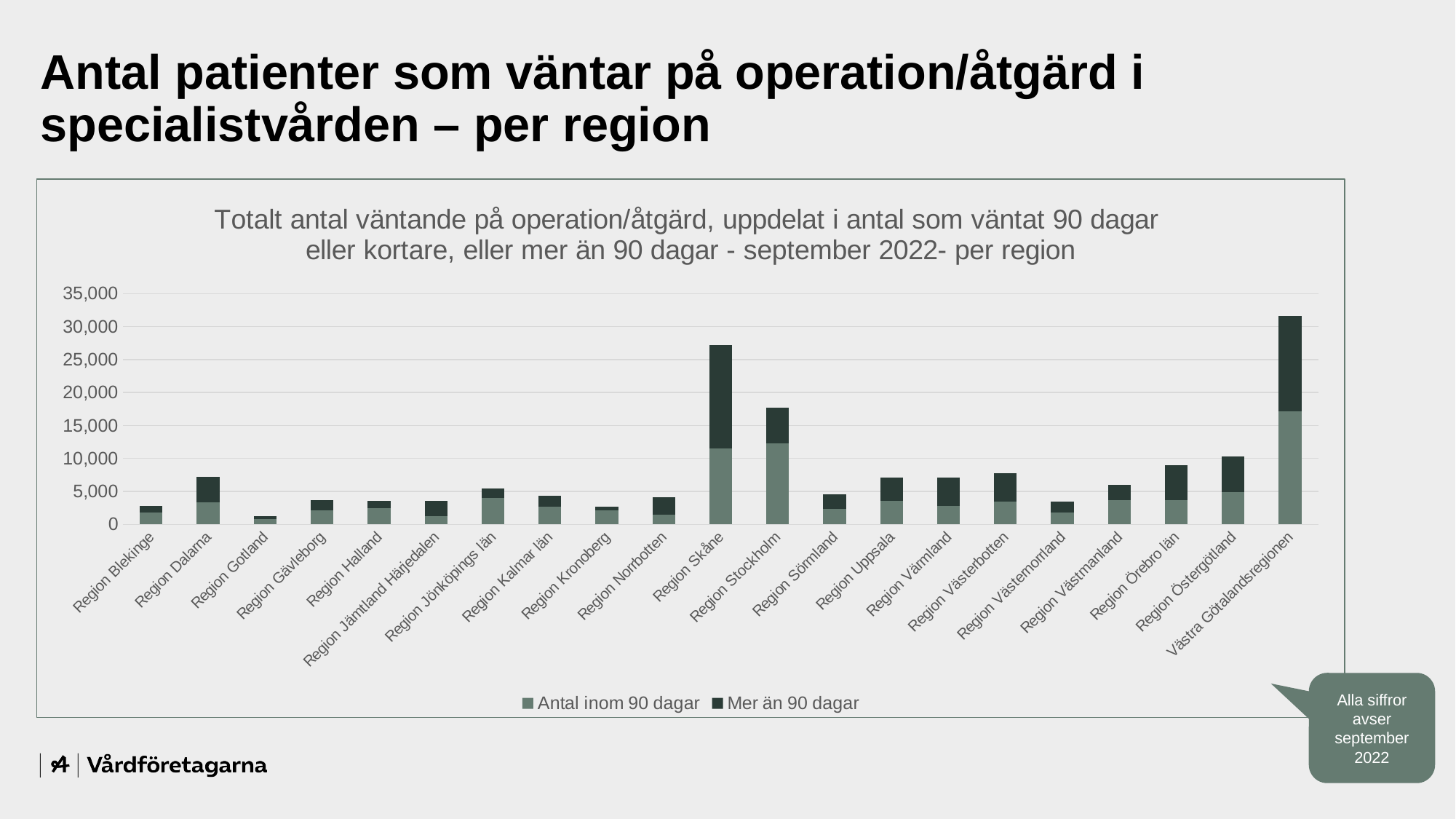
What kind of chart is shown on the slide? Stacked bar chart How many series does the legend list? 2 Which region has the highest total number of waiting patients? Västra Götalandsregionen Is the total value for Region Gotland greater or less than 5,000? less How many regions are shown on the x axis? 21 Is the total value for Region Stockholm greater or less than 15,000? greater Is the total value for Region Skåne greater or less than 25,000? greater Which region has the lowest total number of waiting patients? Region Gotland Which has a larger total bar, Region Skåne or Region Stockholm? Region Skåne Which has a larger total bar, Region Dalarna or Region Gotland? Region Dalarna What are the two legend entries of the chart? Antal inom 90 dagar; Mer än 90 dagar